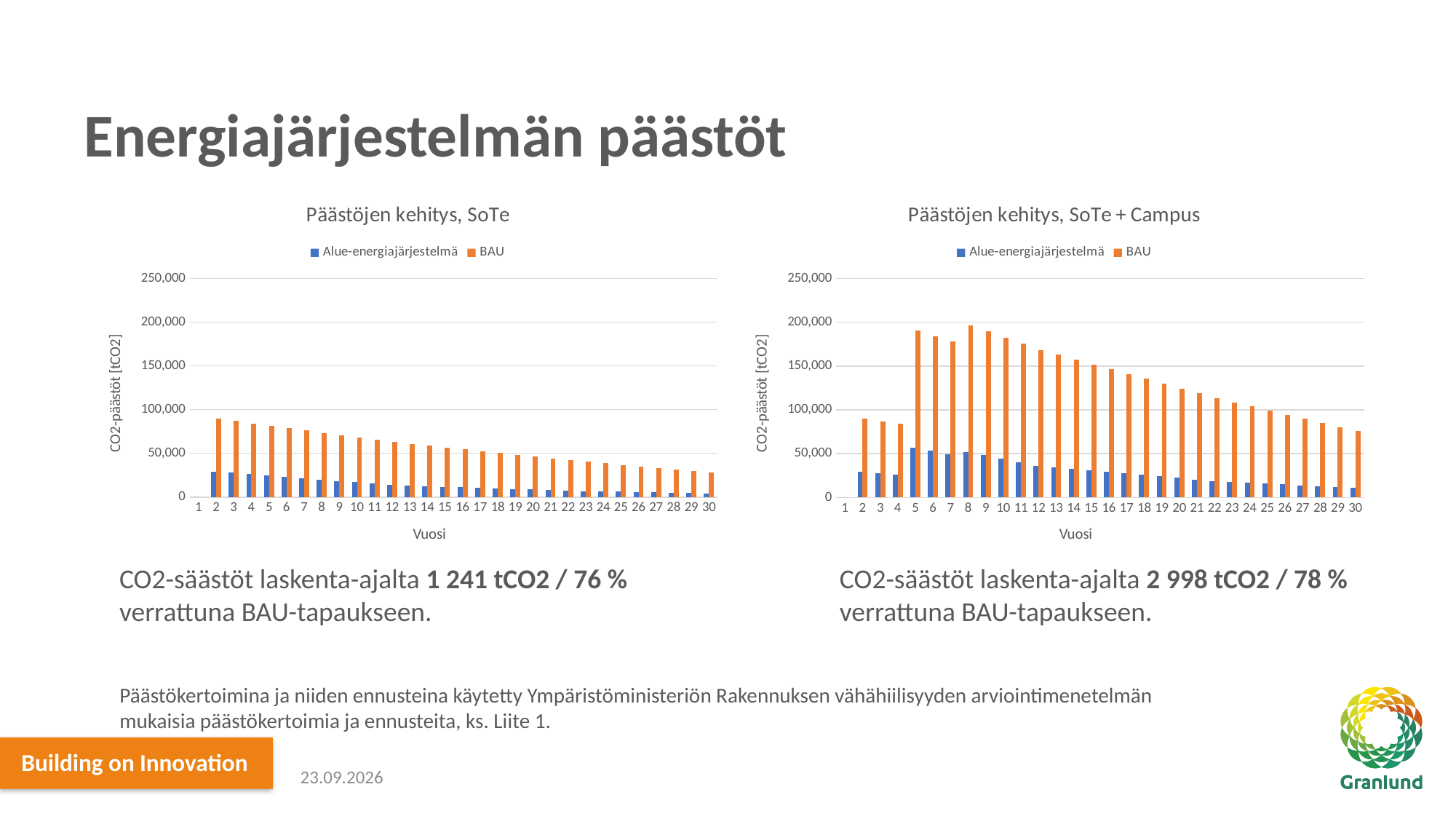
How many series does the legend of the "Päästöjen kehitys, SoTe + Campus" chart list? 2 In the "Päästöjen kehitys, SoTe" chart, do the BAU values rise or fall from year 2 to year 30? fall In the "Päästöjen kehitys, SoTe + Campus" chart, is the BAU value for year 30 greater or less than 100,000? less What is the y-axis label of the "Päästöjen kehitys, SoTe" chart? CO2-päästöt [tCO2] What kind of chart is "Päästöjen kehitys, SoTe"? bar chart How many years are shown on the x axis of the "Päästöjen kehitys, SoTe" chart? 30 In the "Päästöjen kehitys, SoTe" chart, is the BAU value for year 2 greater or less than 50,000? greater In the "Päästöjen kehitys, SoTe + Campus" chart, which is larger for year 5: the BAU value or the Alue-energiajärjestelmä value? BAU In the "Päästöjen kehitys, SoTe" chart, is the BAU value for year 2 greater or less than 100,000? less In the "Päästöjen kehitys, SoTe + Campus" chart, which BAU value is larger: year 4 or year 5? year 5 Which colour represents BAU in the "Päästöjen kehitys, SoTe + Campus" chart? orange